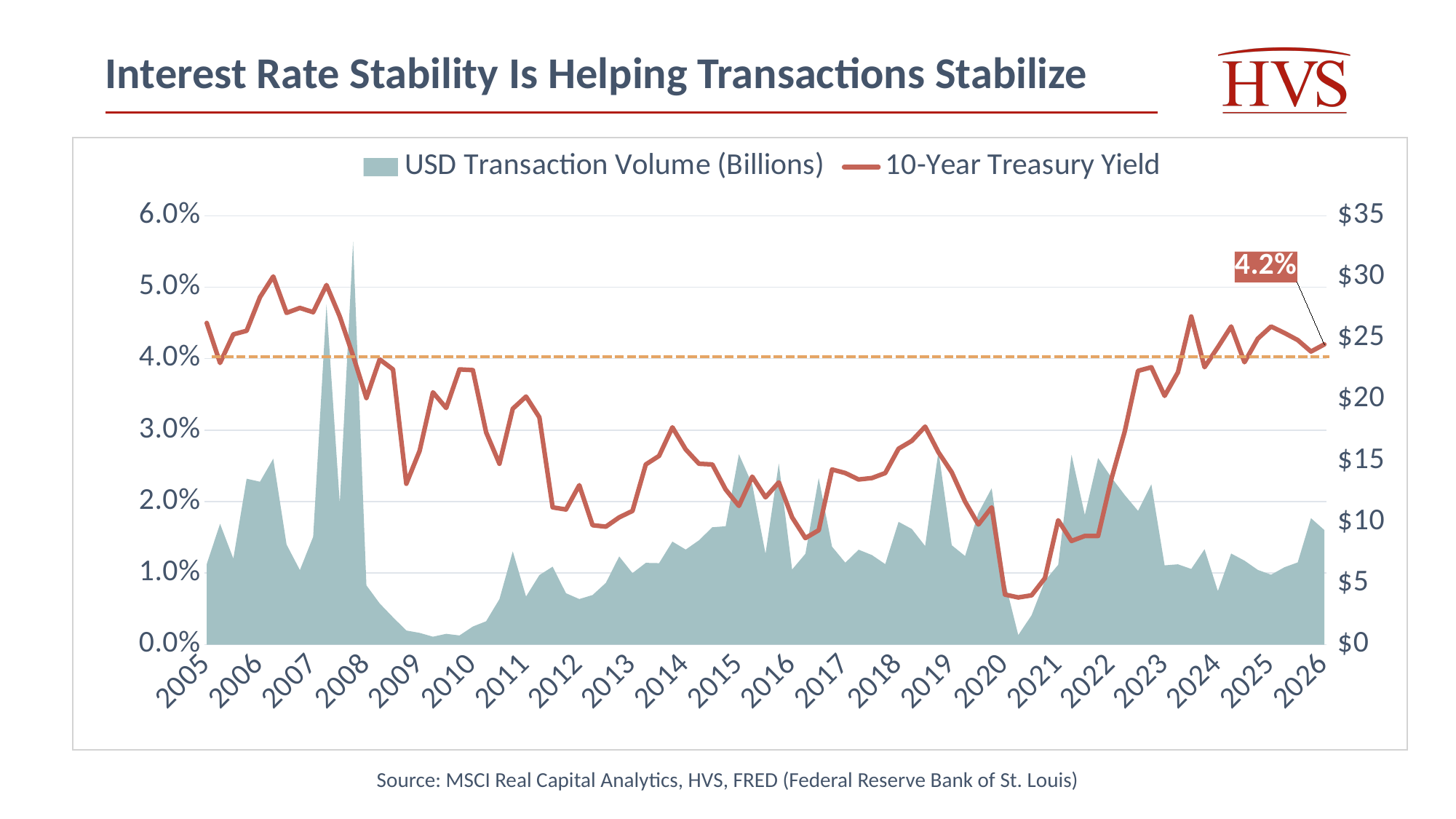
What is the labeled value of the 10-Year Treasury Yield at the end of the series (2026)? 4.2% Is the 10-Year Treasury Yield at its 2020 low greater or less than 1.0%? less How many series does the legend list? 2 Is the USD Transaction Volume in 2009 greater or less than $5 billion? less What are the two series named in the legend? USD Transaction Volume (Billions) and 10-Year Treasury Yield In which year does the USD Transaction Volume reach its highest peak? 2008 What kind of chart is shown on the slide? A combined area and line chart What is the title of the chart slide? Interest Rate Stability Is Helping Transactions Stabilize Which is higher, the 10-Year Treasury Yield in 2007 or in 2012? 2007 Is the peak USD Transaction Volume in 2008 greater or less than $30 billion? greater Does the 10-Year Treasury Yield rise or fall between 2020 and 2023? rise